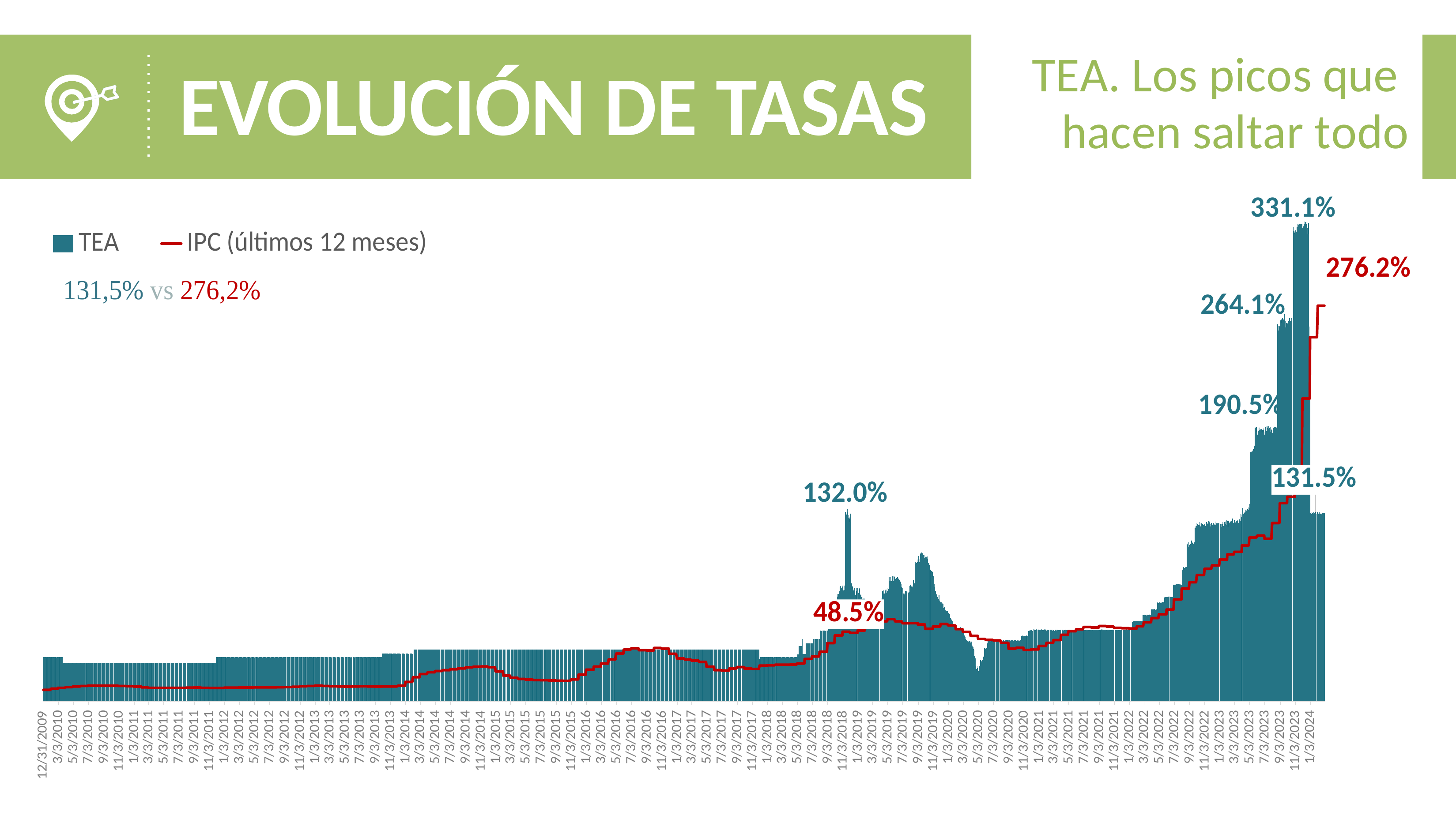
Which is larger: the TEA peak of 331.1% or the final IPC value of 276.2%? The TEA peak of 331.1% What are the two series named in the chart legend? TEA and IPC (últimos 12 meses) How many series does the chart legend list? 2 What is the labelled TEA peak value in late 2018? 132.0% What colour is the IPC (últimos 12 meses) line on the chart? Red What is the difference between the final IPC value of 276.2% and the final TEA value of 131.5%? 144.7 percentage points What is the labelled IPC value shown near the end of 2018? 48.5% Does the IPC line generally rise or fall from 2009 to 2024? Rise What is the difference between the labelled TEA peaks of 331.1% and 264.1%? 67.0 percentage points What is the highest labelled TEA value on the chart? 331.1% What is the labelled value of the IPC line at the right end of the chart? 276.2% What kind of chart is shown on the slide? Bar chart with a line series